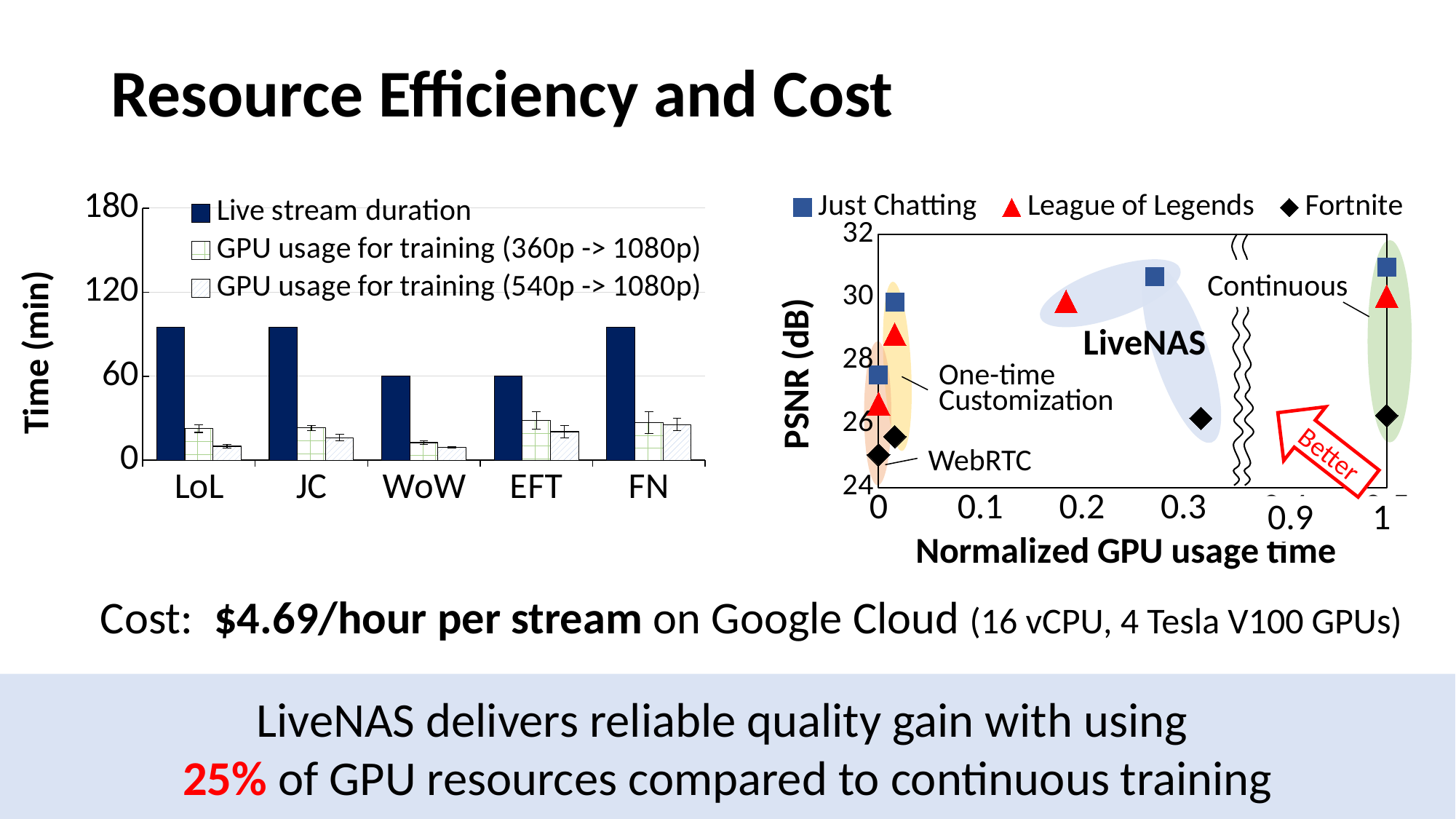
On the right chart, how many series does the legend list? 3 On the right chart, is the PSNR of the Just Chatting point under Continuous (at x = 1) greater or less than 30 dB? greater On the left chart, is the live stream duration for LoL greater or less than 60 minutes? greater On the left chart, which is larger, the live stream duration for JC or for EFT? JC On the left chart, how many series does the legend list? 3 On the left chart, what is the label of the y axis? Time (min) On the left chart, is the live stream duration for WoW greater or less than 120 minutes? less On the right chart, what is the label of the x axis? Normalized GPU usage time On the left chart, how many categories are shown on the x axis? 5 On the left chart, what kind of chart is it? bar chart On the right chart, what kind of chart is it? scatter chart